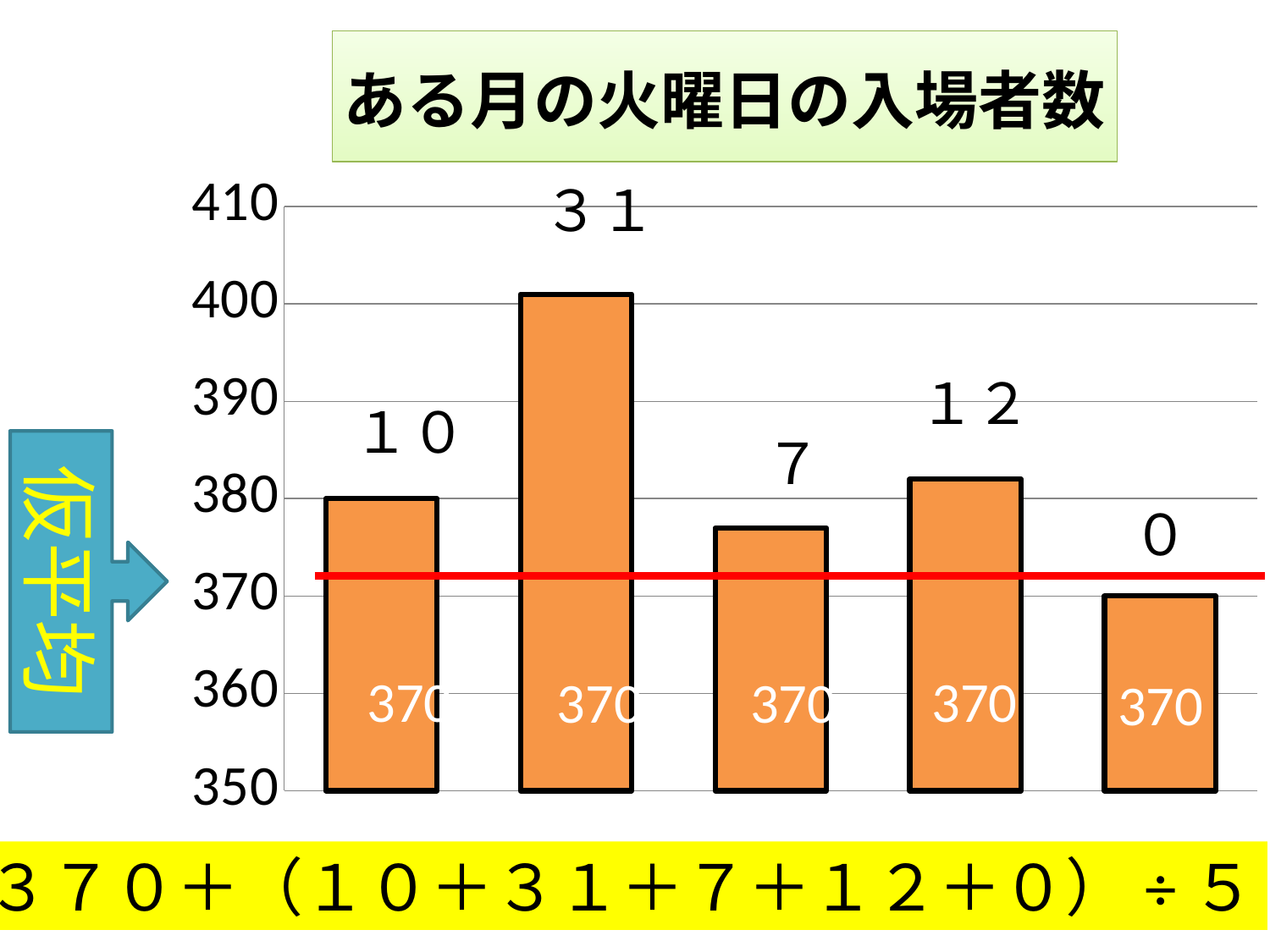
What is the difference between the numbers printed above the second bar and the third bar? 24 What is the title of the chart? ある月の火曜日の入場者数 Is the value of the second bar greater or less than 400? greater What number is printed above the second bar? ３１ What number is printed above the fifth bar? ０ Is the value of the third bar greater or less than 380? less Which bar is the tallest in the chart? the second bar How many bars does the chart contain? 5 Which bar is the shortest in the chart? the fifth bar What value is printed inside each of the bars? 370 What number is printed above the fourth bar? １２ What kind of chart is shown on the slide? bar chart